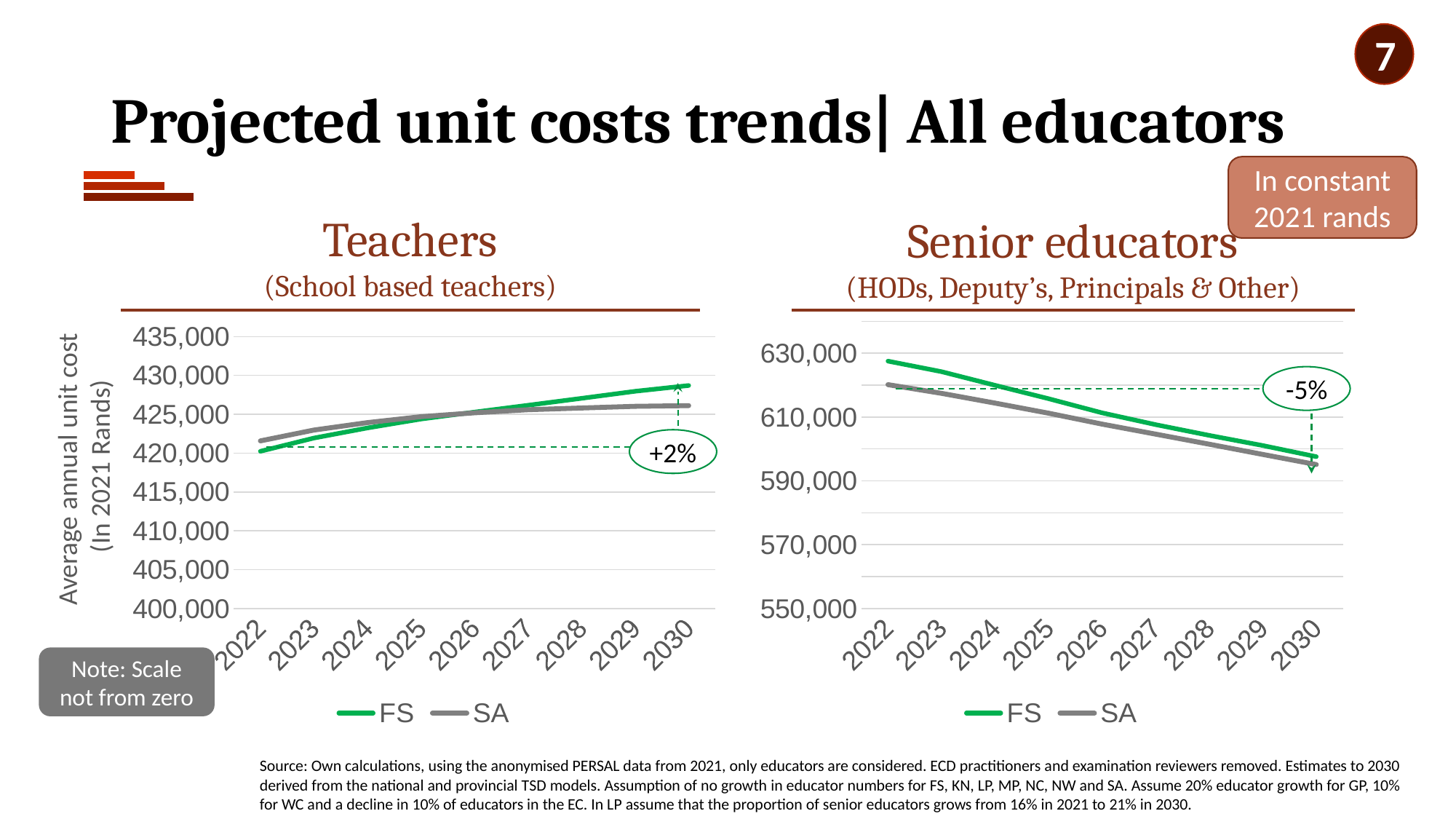
How many years are shown on the x axis of the Teachers chart? 9 In the Teachers chart, do the FS values rise or fall from 2022 to 2030? rise How many series does the legend of the Senior educators chart list? 2 What kind of chart is the Teachers chart? line chart In the Teachers chart, is the FS value for 2030 greater or less than 425,000? greater In the Teachers chart, which series has the higher value in 2030, FS or SA? FS In the Senior educators chart, is the FS value for 2022 greater or less than 620,000? greater In the Senior educators chart, is the SA value for 2030 greater or less than 600,000? less What percentage change is annotated on the Senior educators chart? -5% In the Senior educators chart, which series has the higher value in 2022, FS or SA? FS In the Senior educators chart, do the FS values rise or fall from 2022 to 2030? fall